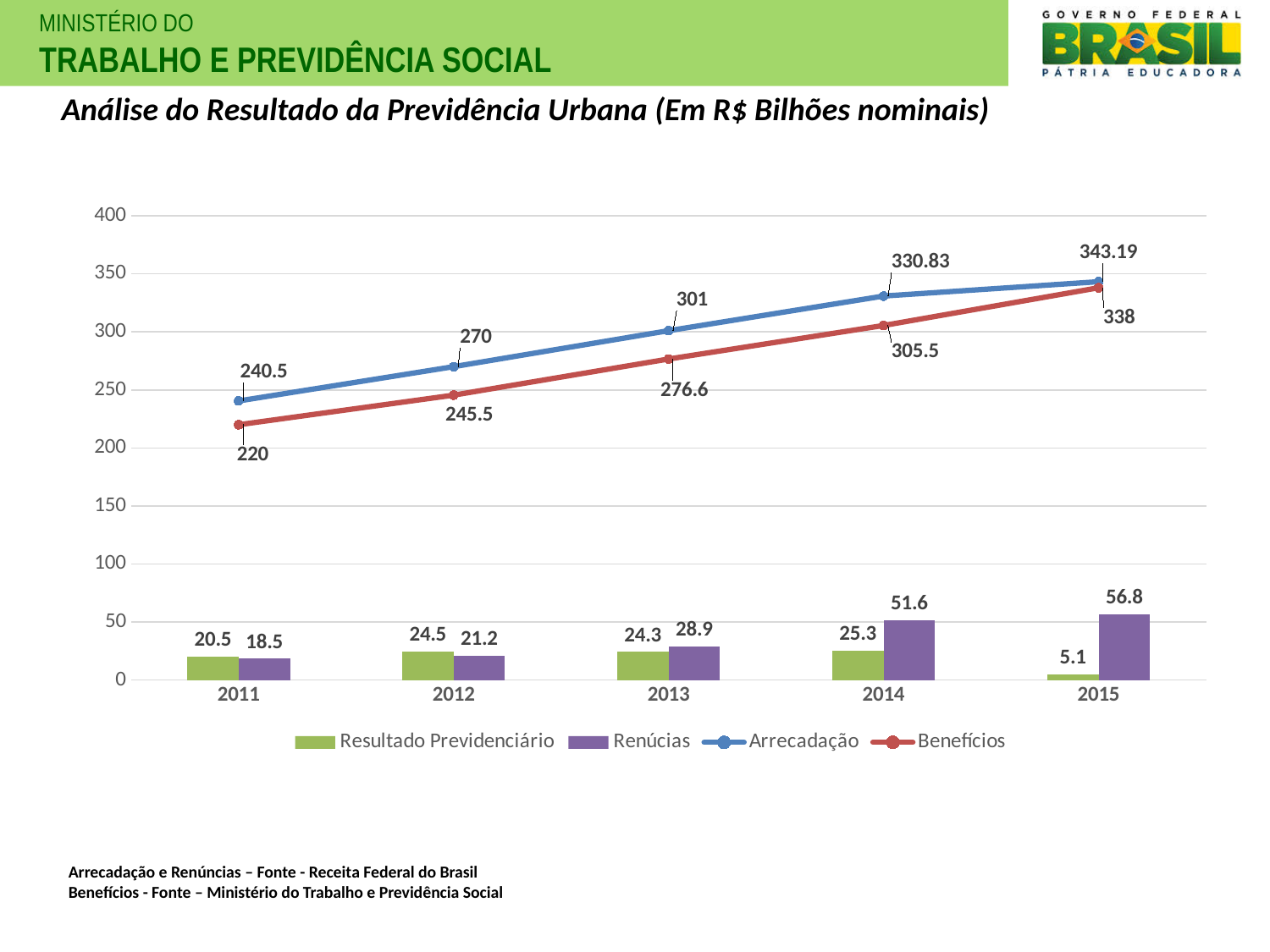
What is the value of Benefícios in 2015? 338 Which is larger in 2013, Resultado Previdenciário or Renúcias? Renúcias In which year is Resultado Previdenciário lowest? 2015 What is the value of Renúcias in 2014? 51.6 What is the title of the chart? Análise do Resultado da Previdência Urbana (Em R$ Bilhões nominais) What is the difference between Arrecadação and Benefícios in 2011? 20.5 What is the value of Arrecadação in 2013? 301 How many series does the legend list? 4 How many years are shown on the x axis? 5 Does Arrecadação rise or fall from 2011 to 2015? rise In which year is Renúcias highest? 2015 What is the value of Resultado Previdenciário in 2015? 5.1